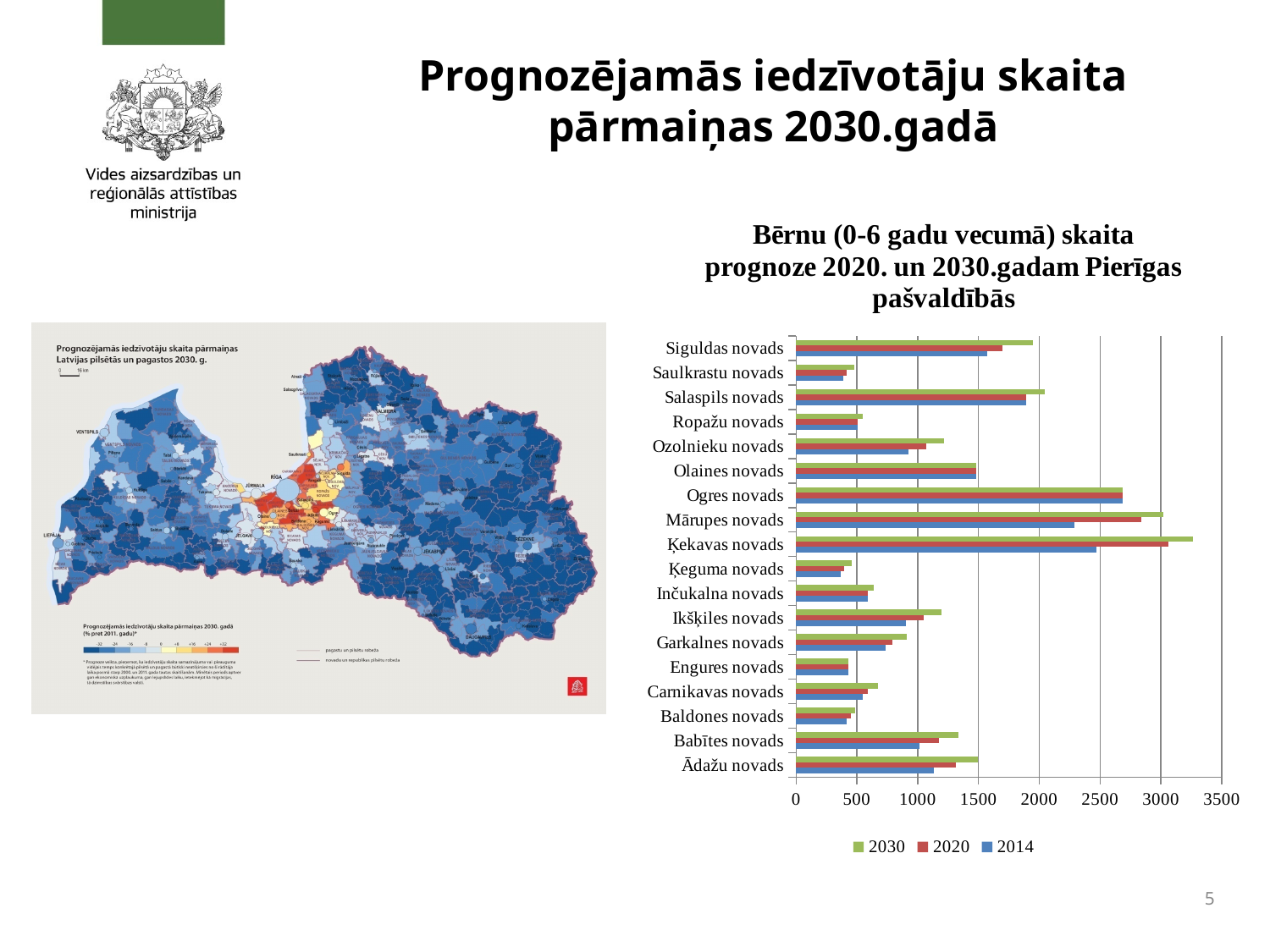
In the bar chart, is the 2030 value for Ropažu novads greater or less than 1000? less What kind of chart is shown on the right side of the slide? bar chart In the bar chart, which has the larger 2030 value: Ozolnieku novads or Olaines novads? Olaines novads In the bar chart, which has the larger 2030 value: Ogres novads or Mārupes novads? Mārupes novads In the bar chart, is the 2014 value for Ogres novads greater or less than 2500? greater How many series does the legend of the bar chart list? 3 In the bar chart, is the 2030 value for Babītes novads greater or less than 1000? greater What are the legend entries of the bar chart? 2030, 2020, 2014 Which municipality has the highest 2030 value in the bar chart? Ķekavas novads How many municipalities (categories) are shown in the bar chart? 18 What is the title of the bar chart? Bērnu (0-6 gadu vecumā) skaita prognoze 2020. un 2030.gadam Pierīgas pašvaldībās